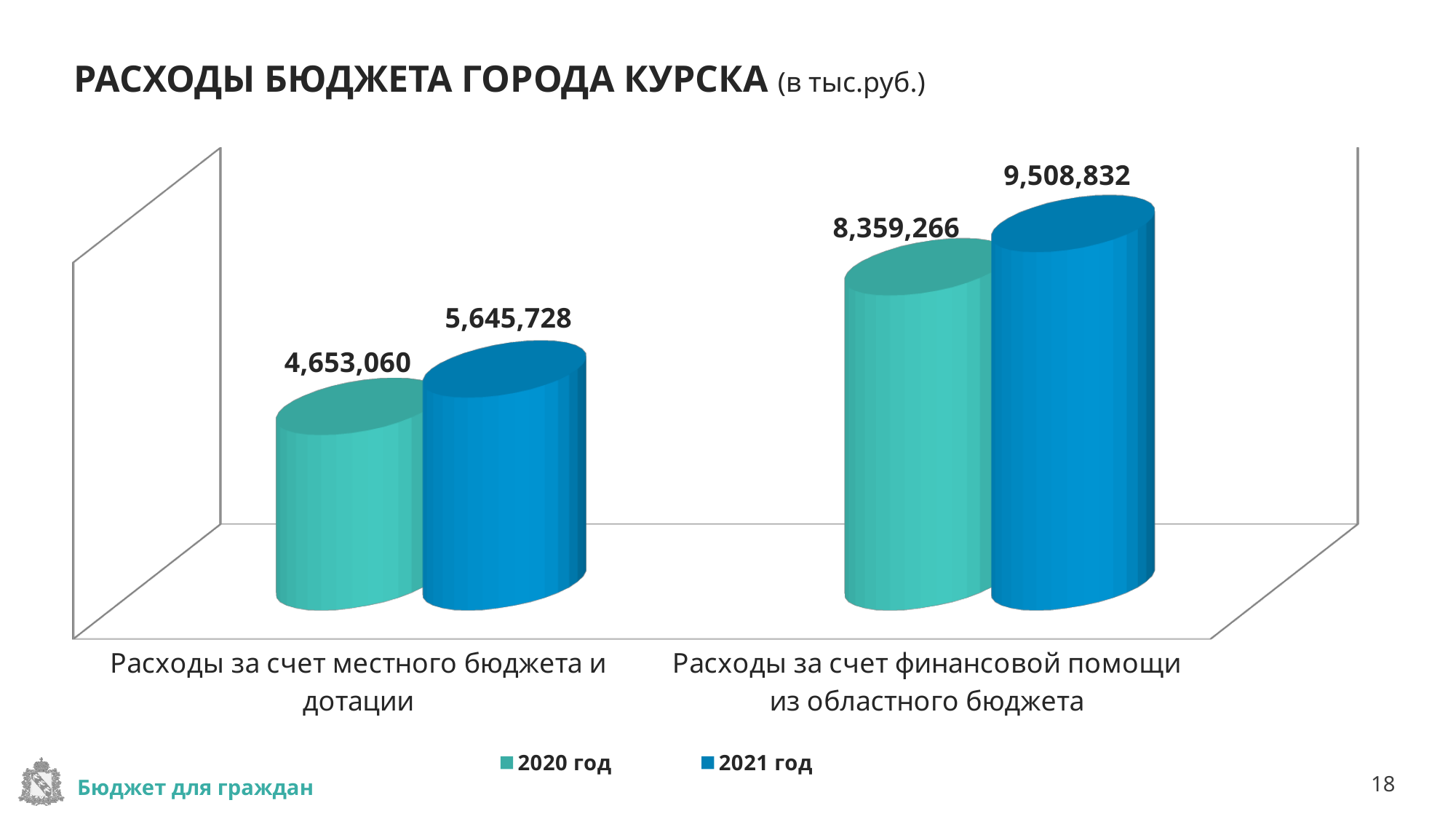
What is the difference between the 2021 год and 2020 год values for 'Расходы за счет финансовой помощи из областного бюджета'? 1,149,566 What is the value for 2021 год for 'Расходы за счет финансовой помощи из областного бюджета'? 9,508,832 Which bar has the highest value on the chart? 2021 год, Расходы за счет финансовой помощи из областного бюджета How many categories are shown on the x axis? 2 What is the difference between the 2021 год and 2020 год values for 'Расходы за счет местного бюджета и дотации'? 992,668 What is the value for 2020 год for 'Расходы за счет финансовой помощи из областного бюджета'? 8,359,266 What is the value for 2021 год for 'Расходы за счет местного бюджета и дотации'? 5,645,728 What kind of chart is shown on the slide? Bar chart How many series does the legend list? 2 What is the value for 2020 год for 'Расходы за счет местного бюджета и дотации'? 4,653,060 Which bar has the lowest value on the chart? 2020 год, Расходы за счет местного бюджета и дотации Which is larger: the 2020 год value for 'Расходы за счет финансовой помощи из областного бюджета' or the 2021 год value for 'Расходы за счет местного бюджета и дотации'? 2020 год value for 'Расходы за счет финансовой помощи из областного бюджета'